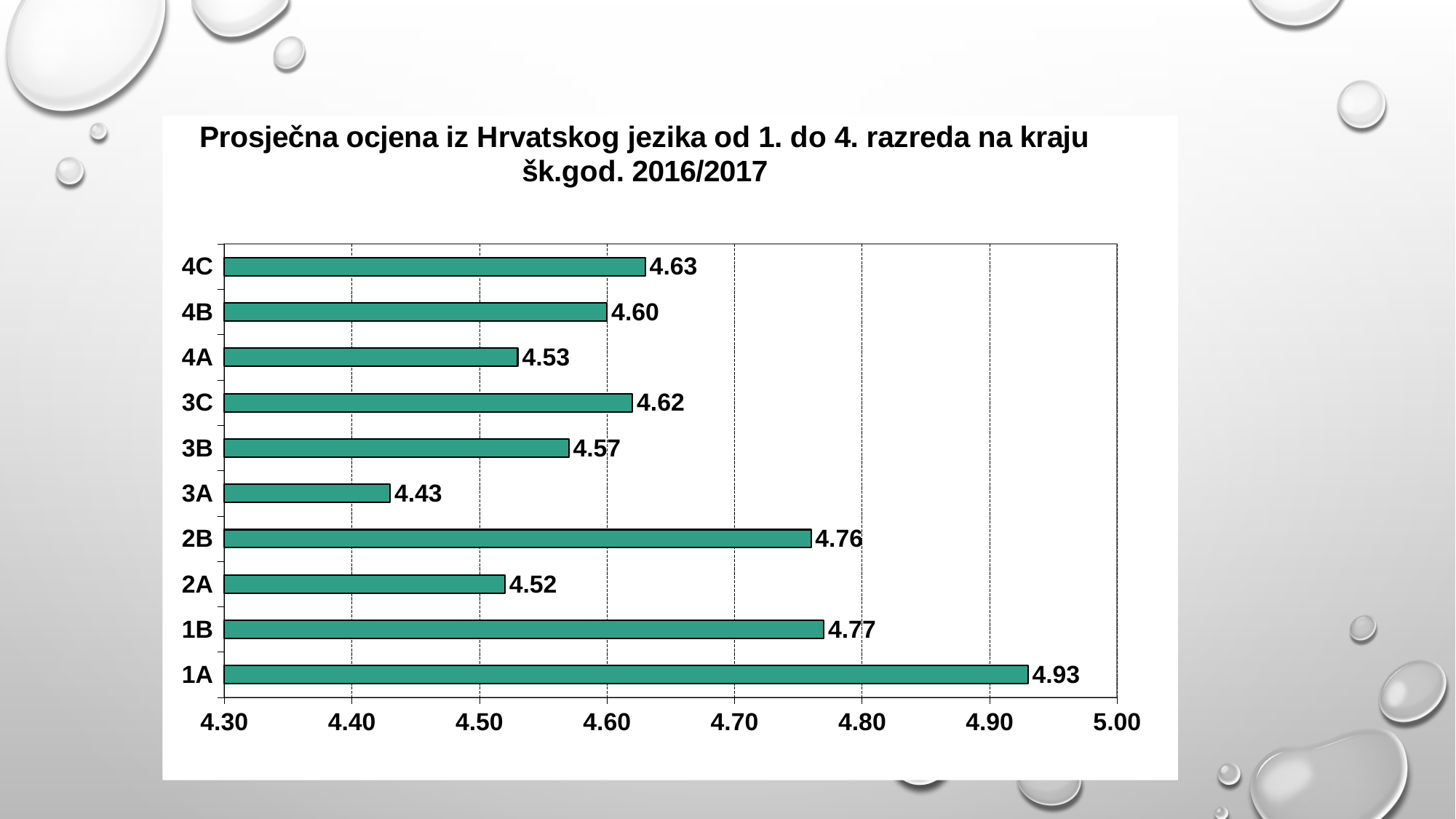
What is the average grade for class 3A? 4.43 What is the difference between the average grades of 1A and 3A? 0.50 Which class has a higher average grade, 2B or 2A? 2B What kind of chart is shown on the slide? Bar chart What is the average grade for class 1A? 4.93 What is the average grade for class 2B? 4.76 Which class has the highest average grade? 1A How many classes are shown in the chart? 10 Which class has the lowest average grade? 3A Is the value for 3B greater or less than 4.60? less What is the difference between the average grades of 4C and 4A? 0.10 What is the title of the chart? Prosječna ocjena iz Hrvatskog jezika od 1. do 4. razreda na kraju šk.god. 2016/2017